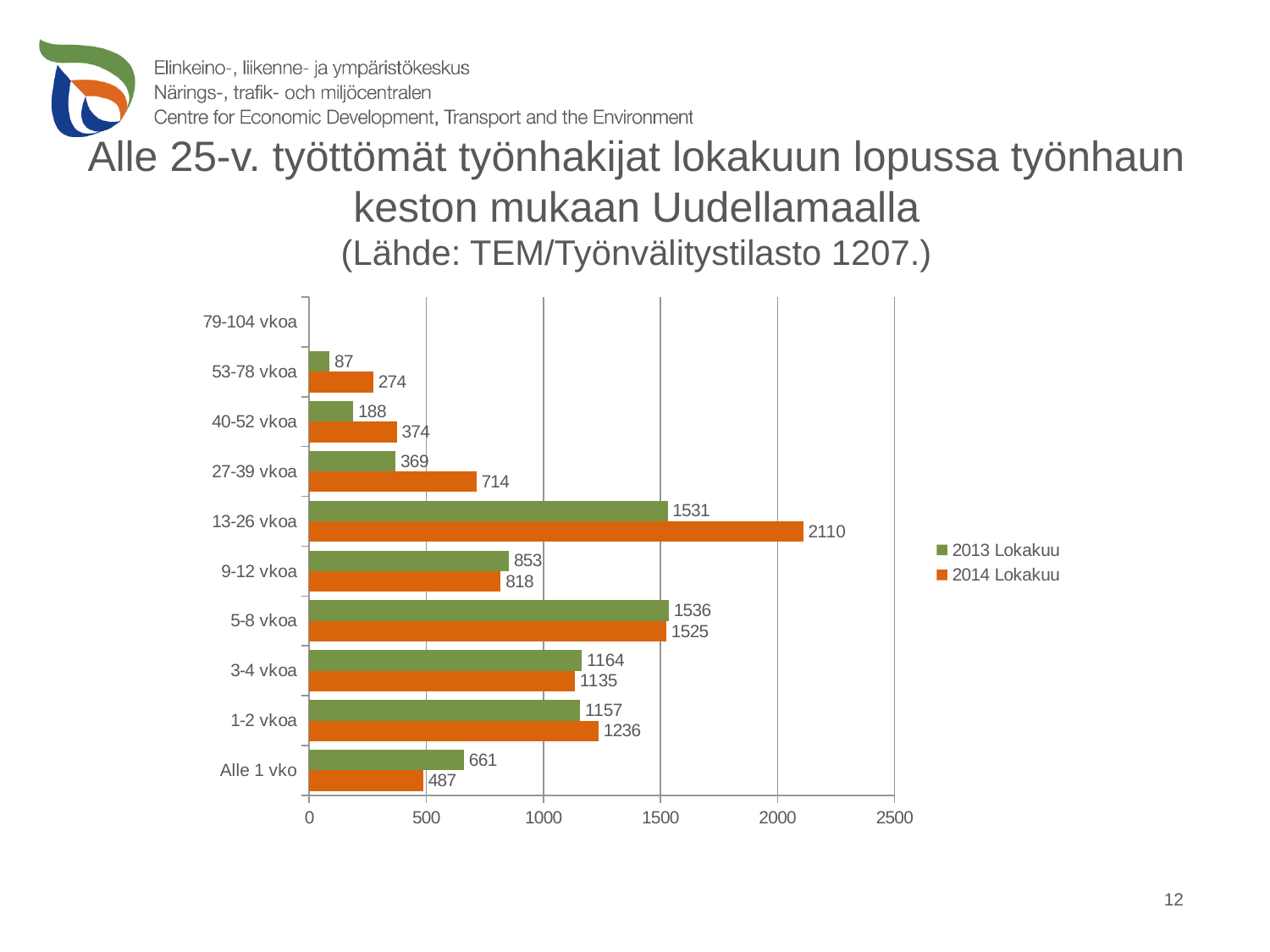
What is the difference between the 2014 Lokakuu and 2013 Lokakuu values for 27-39 vkoa? 345 How many categories are shown on the vertical axis? 10 What is the value for Alle 1 vko in the 2014 Lokakuu series? 487 What is the value for 13-26 vkoa in the 2014 Lokakuu series? 2110 How many series does the legend list? 2 What kind of chart is shown on the slide? bar chart Which is larger for 1-2 vkoa: the 2013 Lokakuu value or the 2014 Lokakuu value? 2014 Lokakuu Which category has the highest value in the 2014 Lokakuu series? 13-26 vkoa What is the value for 53-78 vkoa in the 2013 Lokakuu series? 87 Which category has the lowest value in the 2013 Lokakuu series among those with a printed label? 53-78 vkoa Which colour represents the 2014 Lokakuu series? orange Is the 2013 Lokakuu value for 9-12 vkoa greater or less than 1000? less